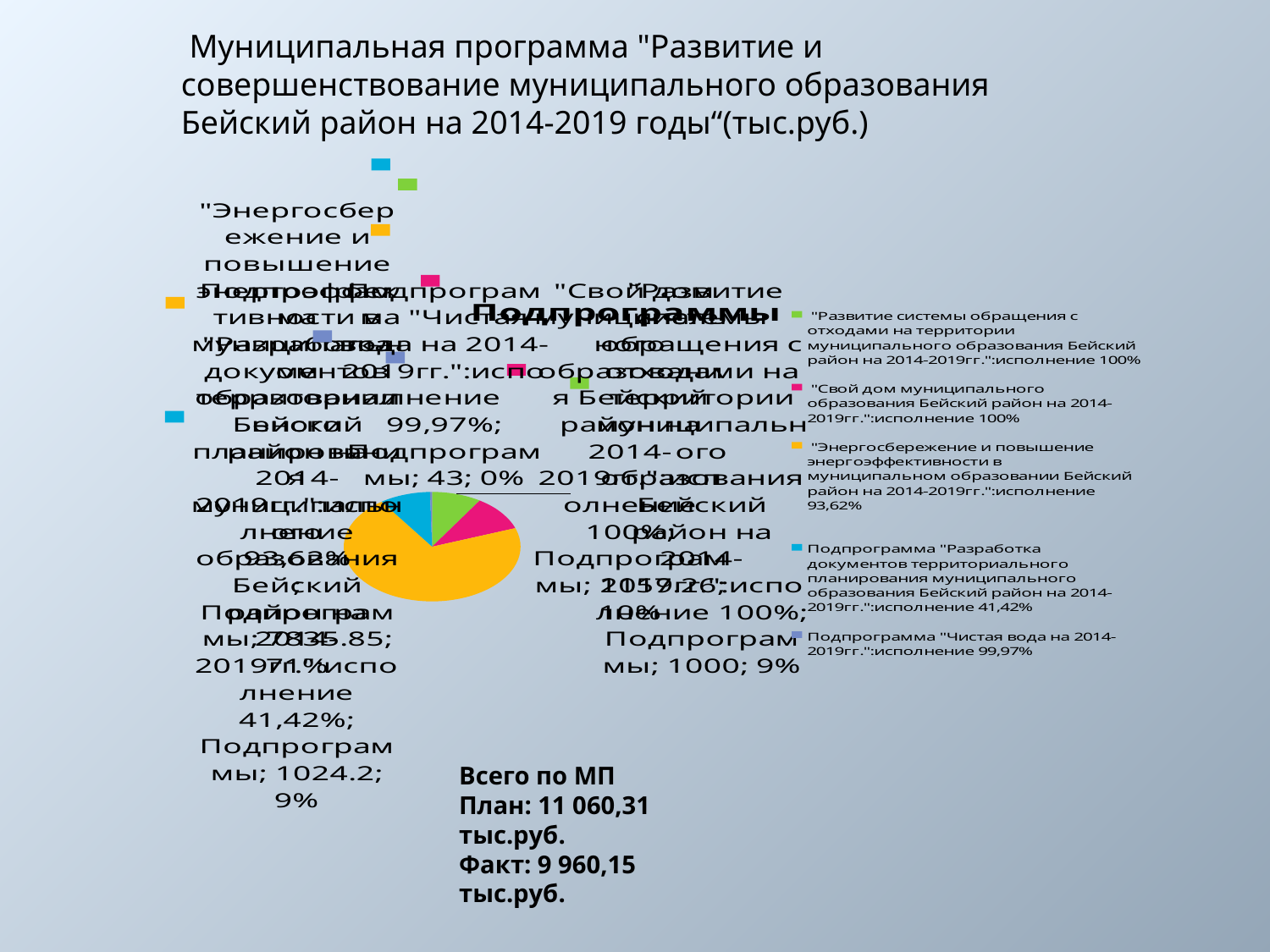
What share of the pie does the smallest slice represent? 0% Which subprogram has the largest slice of the pie chart? "Энергосбережение и повышение энергоэффективности в муниципальном образовании Бейский район на 2014-2019гг." What value is printed on the data label of the smallest slice? 43 How many slices does the pie chart have? 5 What value is printed on the data label of the largest slice? 7835.85 How many entries does the legend of the pie chart list? 5 According to the legend, what is the execution percentage for the subprogram "Чистая вода на 2014-2019гг."? 99,97% Is the value of the largest slice greater or less than 5000? greater What kind of chart is shown on the slide? pie chart What share of the pie does the largest slice represent? 71% What is the title of the pie chart? Подпрограммы